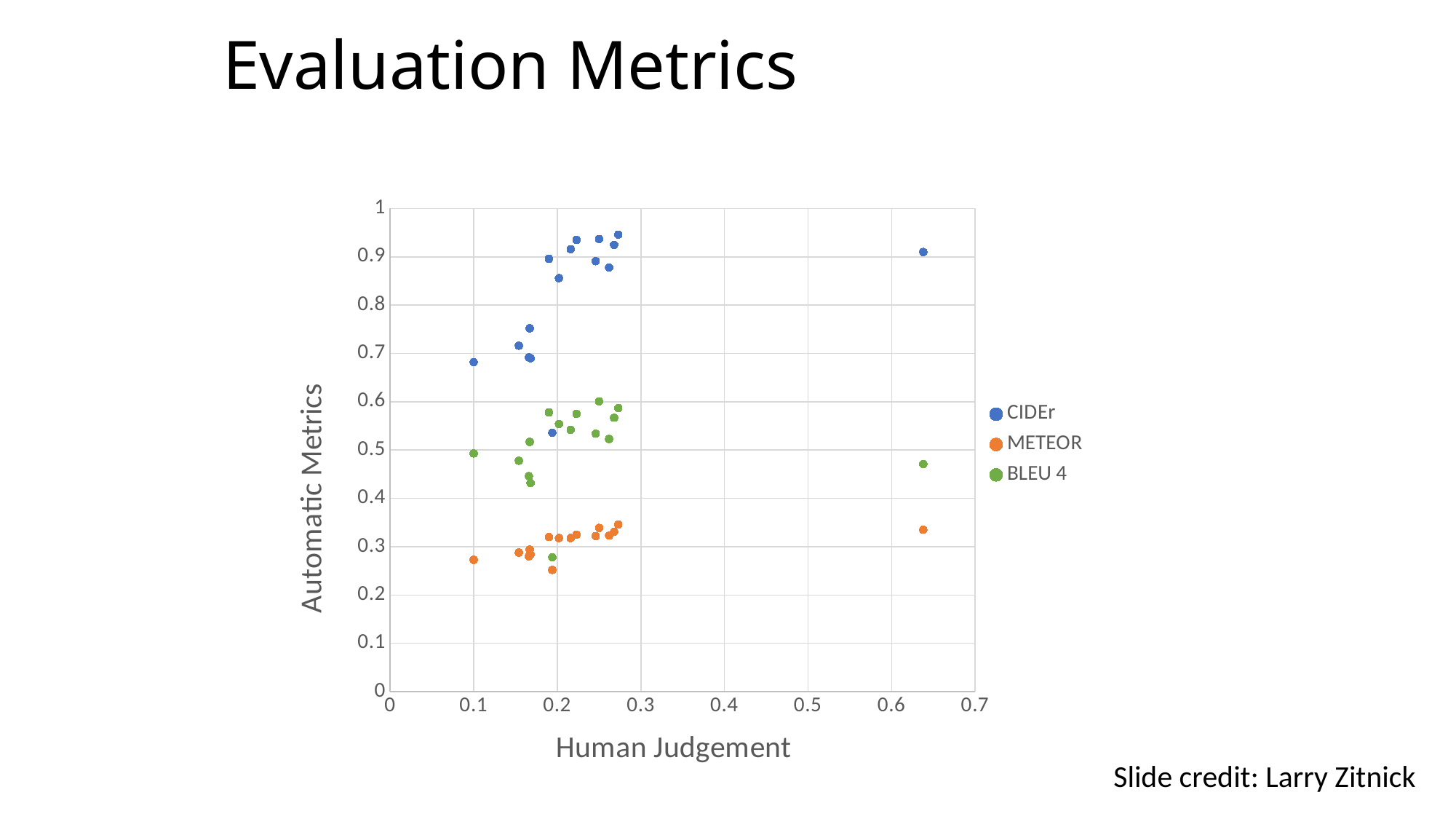
What is the title of the horizontal axis? Human Judgement How many series does the legend list? 3 Is the CIDEr value at Human Judgement 0.1 greater or less than 0.6? greater Which series has the lowest Automatic Metrics values overall? METEOR Is the METEOR value at Human Judgement 0.64 greater or less than 0.4? less Is the CIDEr value at Human Judgement 0.64 greater or less than 0.8? greater What is the title of the vertical axis? Automatic Metrics Do the CIDEr values generally rise or fall as Human Judgement increases from 0.1 to 0.3? rise At Human Judgement 0.64, which is larger, the CIDEr value or the BLEU 4 value? CIDEr Which series has the highest Automatic Metrics values overall? CIDEr What kind of chart is shown on the slide? Scatter chart